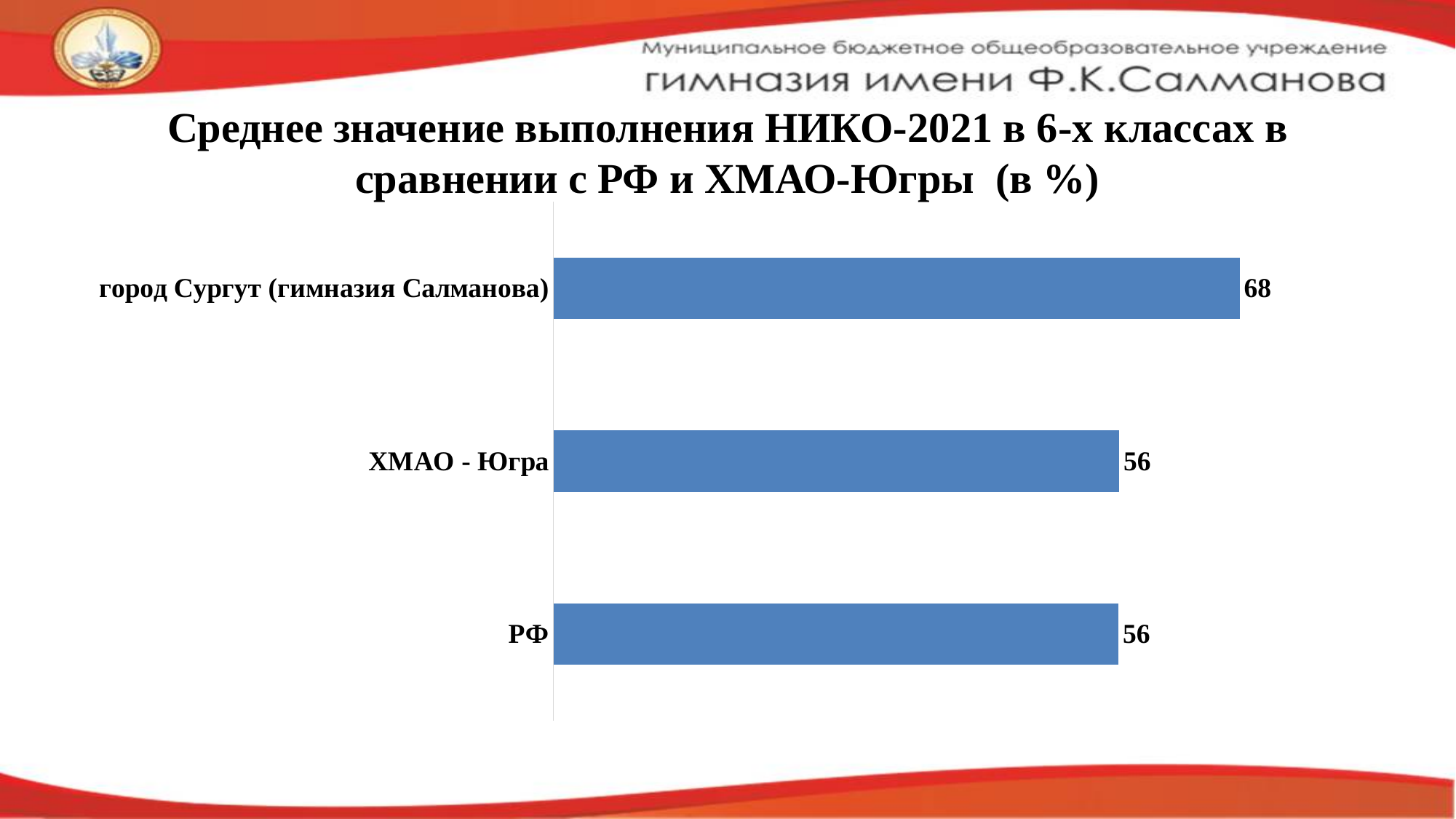
What is the value for город Сургут (гимназия Салманова)? 68 What is the value for РФ? 56 What is the title of the chart? Среднее значение выполнения НИКО-2021 в 6-х классах в сравнении с РФ и ХМАО-Югры (в %) What colour are the bars in the chart? blue What kind of chart is shown on the slide? bar chart What is the difference between the value for город Сургут (гимназия Салманова) and the value for РФ? 12 Are the values for ХМАО - Югра and РФ equal? yes What is the difference between the value for ХМАО - Югра and the value for РФ? 0 How many categories are shown in the chart? 3 Which category has the highest value? город Сургут (гимназия Салманова) Which is larger, the value for город Сургут (гимназия Салманова) or the value for ХМАО - Югра? город Сургут (гимназия Салманова) What is the value for ХМАО - Югра? 56